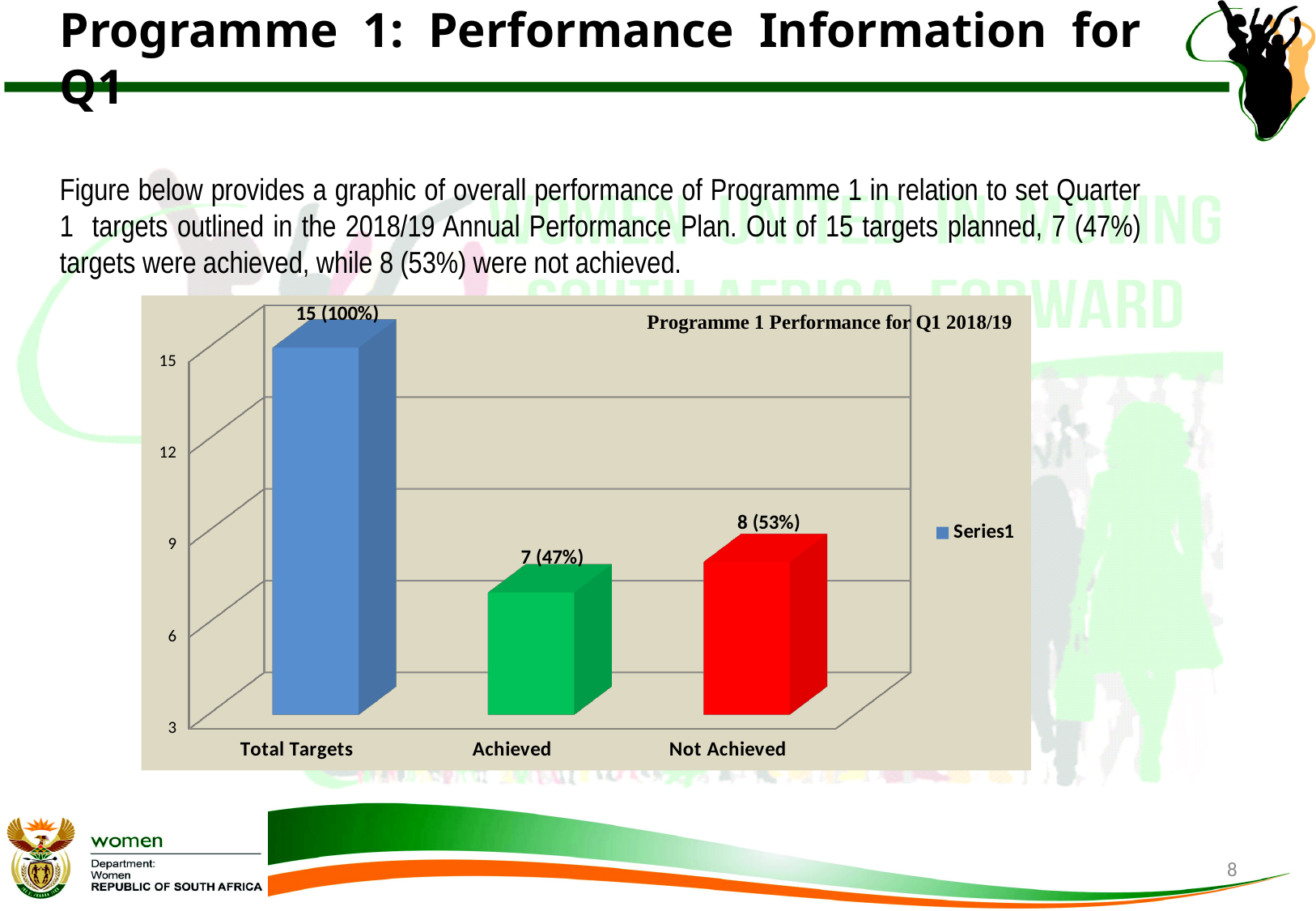
What is the title of the chart? Programme 1 Performance for Q1 2018/19 Is the value for Not Achieved greater or less than 9? less What is the value shown for Achieved? 7 (47%) How many series does the legend list? 1 What is the value shown for Total Targets? 15 (100%) How many categories are shown on the x axis? 3 What kind of chart is shown? bar chart What is the difference between the Total Targets value and the Achieved value? 8 Which is larger, the value for Achieved or the value for Not Achieved? Not Achieved Which category has the lowest value? Achieved Which category has the highest value? Total Targets What is the value shown for Not Achieved? 8 (53%)